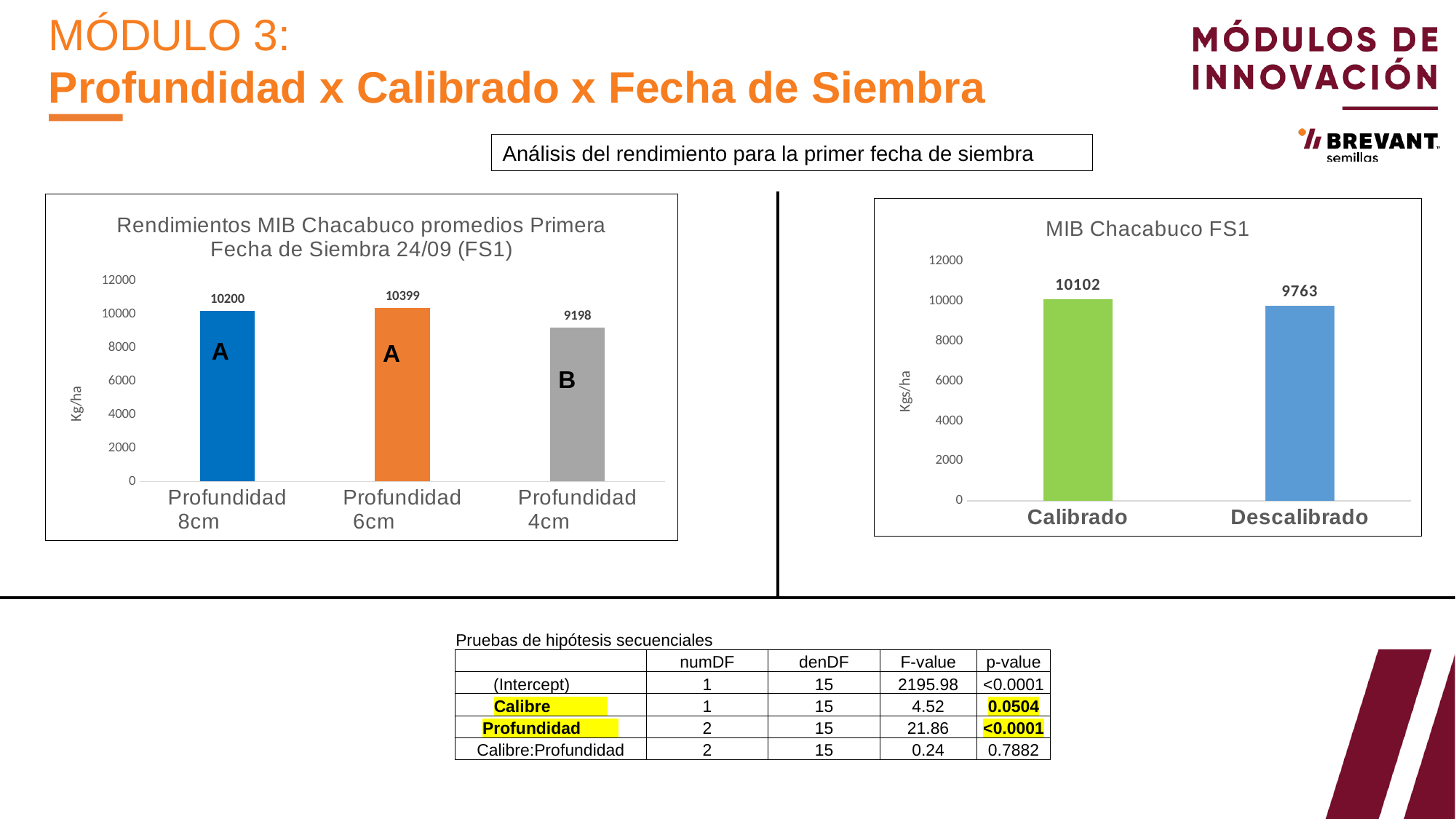
In the right chart (MIB Chacabuco FS1), which is larger, Calibrado or Descalibrado? Calibrado In the right chart (MIB Chacabuco FS1), what is the value for Descalibrado? 9763 In the left chart (Rendimientos MIB Chacabuco promedios Primera Fecha de Siembra 24/09 (FS1)), what is the value for Profundidad 8cm? 10200 In the left chart (Rendimientos MIB Chacabuco promedios Primera Fecha de Siembra 24/09 (FS1)), which category has the lowest value? Profundidad 4cm In the left chart (Rendimientos MIB Chacabuco promedios Primera Fecha de Siembra 24/09 (FS1)), what is the value for Profundidad 4cm? 9198 In the left chart (Rendimientos MIB Chacabuco promedios Primera Fecha de Siembra 24/09 (FS1)), what is the difference between the values for Profundidad 6cm and Profundidad 4cm? 1201 What kind of chart is the right chart (MIB Chacabuco FS1)? Bar chart In the left chart (Rendimientos MIB Chacabuco promedios Primera Fecha de Siembra 24/09 (FS1)), what statistical group letter is shown on the Profundidad 4cm bar? B In the left chart (Rendimientos MIB Chacabuco promedios Primera Fecha de Siembra 24/09 (FS1)), which category has the highest value? Profundidad 6cm In the left chart (Rendimientos MIB Chacabuco promedios Primera Fecha de Siembra 24/09 (FS1)), how many categories are plotted? 3 In the right chart (MIB Chacabuco FS1), what is the difference between the values for Calibrado and Descalibrado? 339 In the right chart (MIB Chacabuco FS1), what is the value for Calibrado? 10102